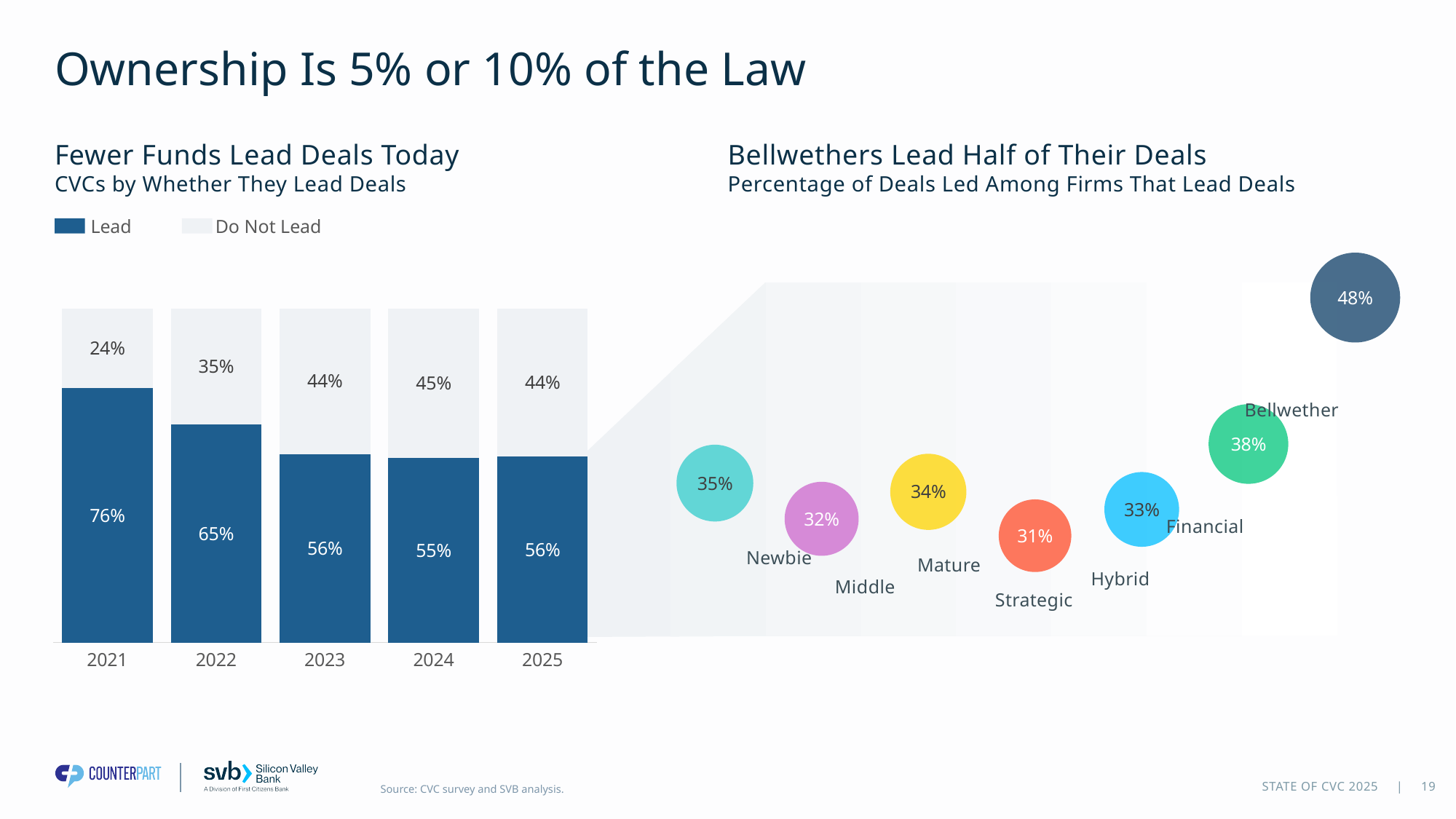
In the 'Bellwethers Lead Half of Their Deals' chart, what percentage of deals do Bellwether firms lead? 48% In the 'Bellwethers Lead Half of Their Deals' chart, which firm type has the lowest percentage of deals led? Strategic In the 'Fewer Funds Lead Deals Today' chart, by how many percentage points did the 'Lead' share fall from 2021 to 2025? 20 percentage points In the 'Fewer Funds Lead Deals Today' chart, what percentage of CVCs led deals in 2021? 76% In the 'Bellwethers Lead Half of Their Deals' chart, which is larger: the value for Newbie or the value for Middle? Newbie In the 'Fewer Funds Lead Deals Today' chart, does the 'Lead' share generally rise or fall from 2021 to 2025? Fall What type of chart is 'Fewer Funds Lead Deals Today'? Stacked bar chart How many firm types are shown in the 'Bellwethers Lead Half of Their Deals' chart? 7 How many series does the legend of the 'Fewer Funds Lead Deals Today' chart list? 2 In the 'Fewer Funds Lead Deals Today' chart, what is the 'Do Not Lead' value for 2024? 45% In the 'Fewer Funds Lead Deals Today' chart, which year has the lowest 'Lead' share? 2024 In the 'Fewer Funds Lead Deals Today' chart, which year has the highest 'Lead' share? 2021